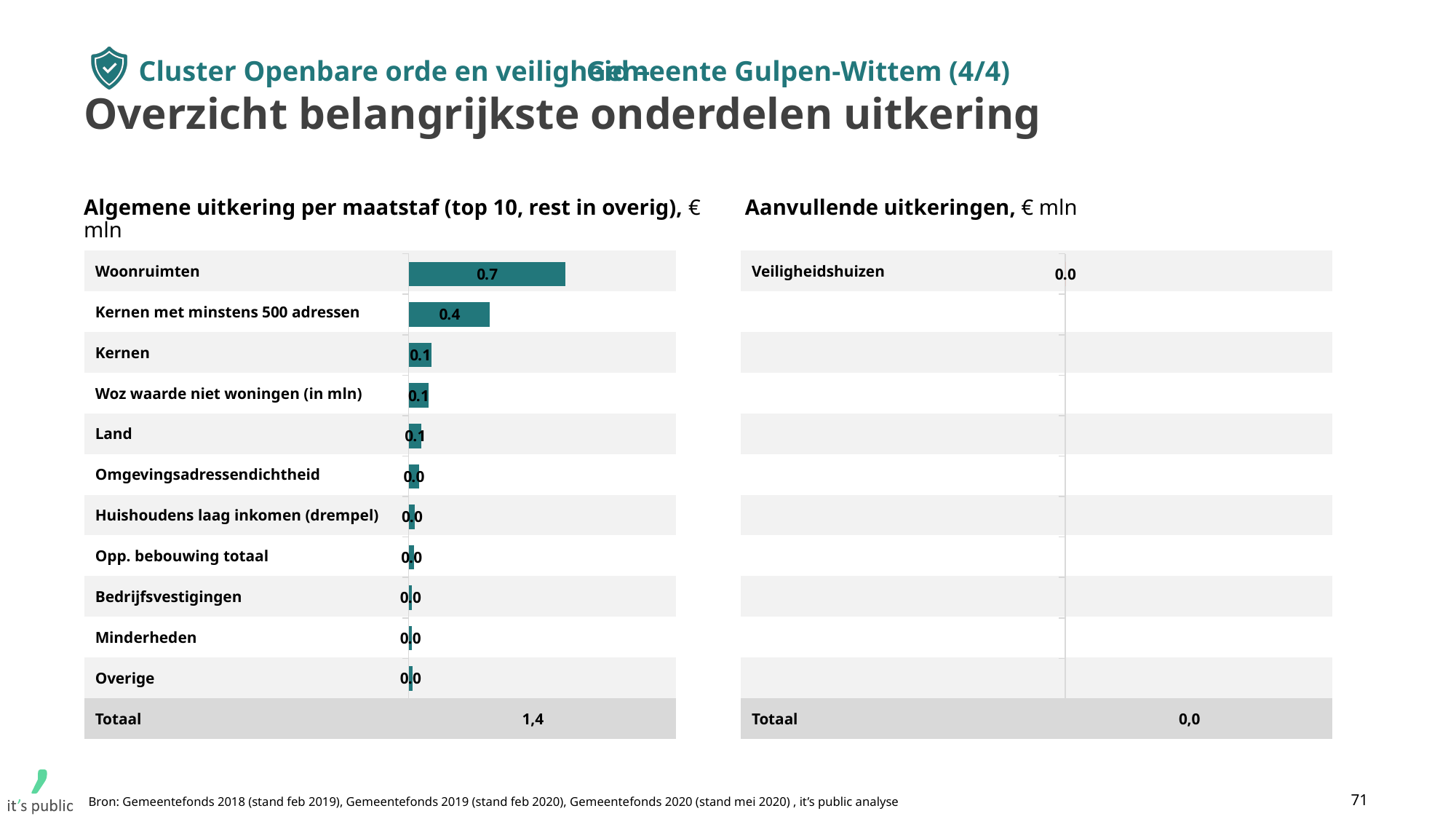
In the chart 'Algemene uitkering per maatstaf', what is the value for Kernen? 0.1 What is the Totaal shown for the chart 'Algemene uitkering per maatstaf'? 1,4 In the chart 'Algemene uitkering per maatstaf', what is the value for Woonruimten? 0.7 What is the Totaal shown for the chart 'Aanvullende uitkeringen'? 0,0 In what unit are the values in the chart 'Aanvullende uitkeringen' expressed? € mln What type of chart is 'Algemene uitkering per maatstaf'? Bar chart In the chart 'Algemene uitkering per maatstaf', what is the value for Kernen met minstens 500 adressen? 0.4 In the chart 'Aanvullende uitkeringen', what is the value for Veiligheidshuizen? 0.0 How many categories are listed in the chart 'Algemene uitkering per maatstaf' (excluding the Totaal row)? 11 In the chart 'Algemene uitkering per maatstaf', which is larger: Woonruimten or Kernen? Woonruimten In the chart 'Algemene uitkering per maatstaf', what is the difference between Woonruimten and Kernen met minstens 500 adressen? 0.3 In the chart 'Algemene uitkering per maatstaf', which category has the highest value? Woonruimten